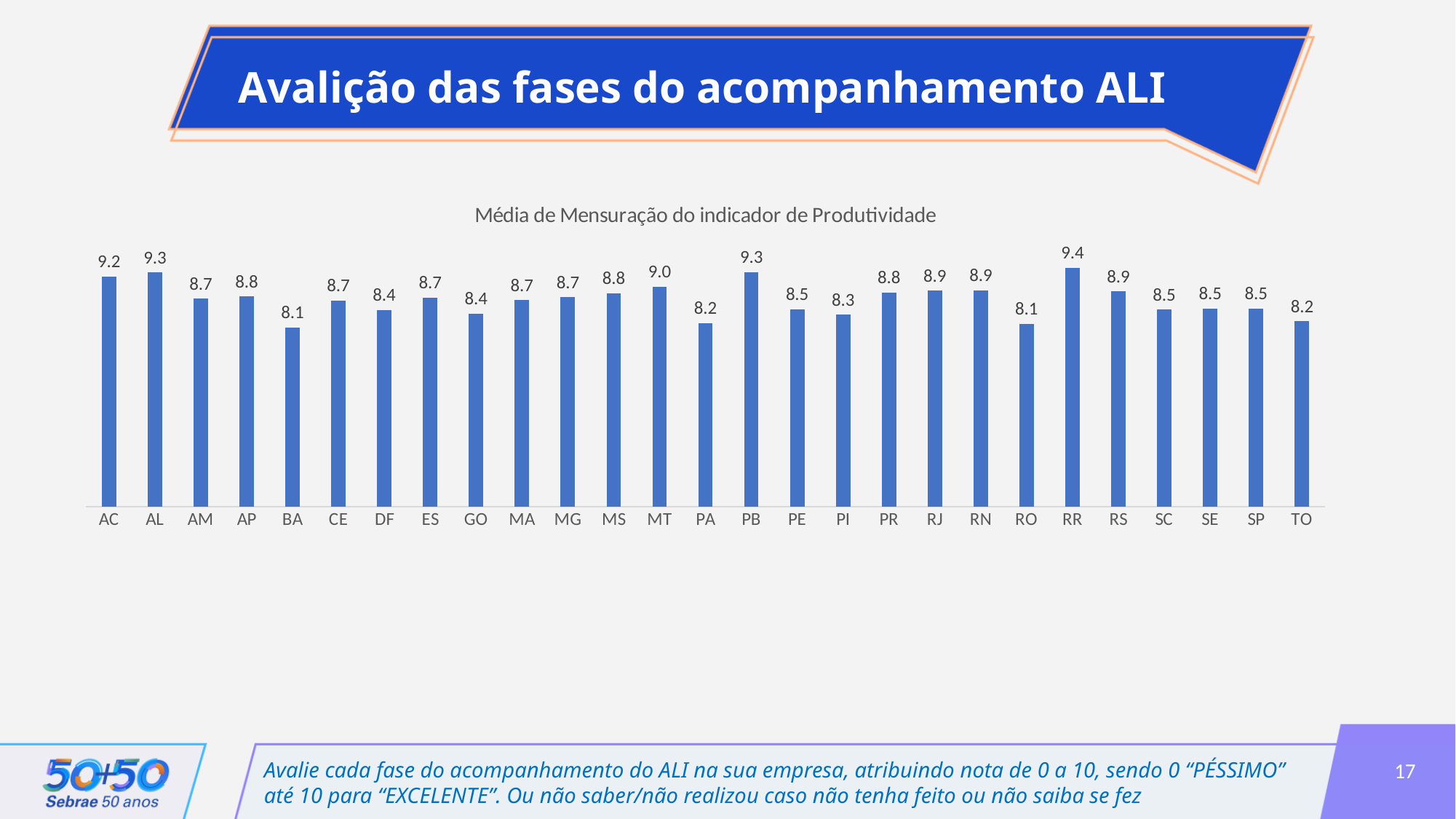
How many states are shown in the chart? 27 What is the value for PB in the chart? 9.3 What is the difference between the values for AL and PA? 1.1 What is the difference between the values for RR and RO? 1.3 What is the value for BA in the chart? 8.1 Which state has the highest value in the chart? RR What is the value for MT in the chart? 9.0 Which has a larger value, PI or RJ? RJ What is the title of the chart? Média de Mensuração do indicador de Produtividade What kind of chart is shown on the slide? Bar chart Which has a larger value, AC or DF? AC What is the value for RR in the chart? 9.4